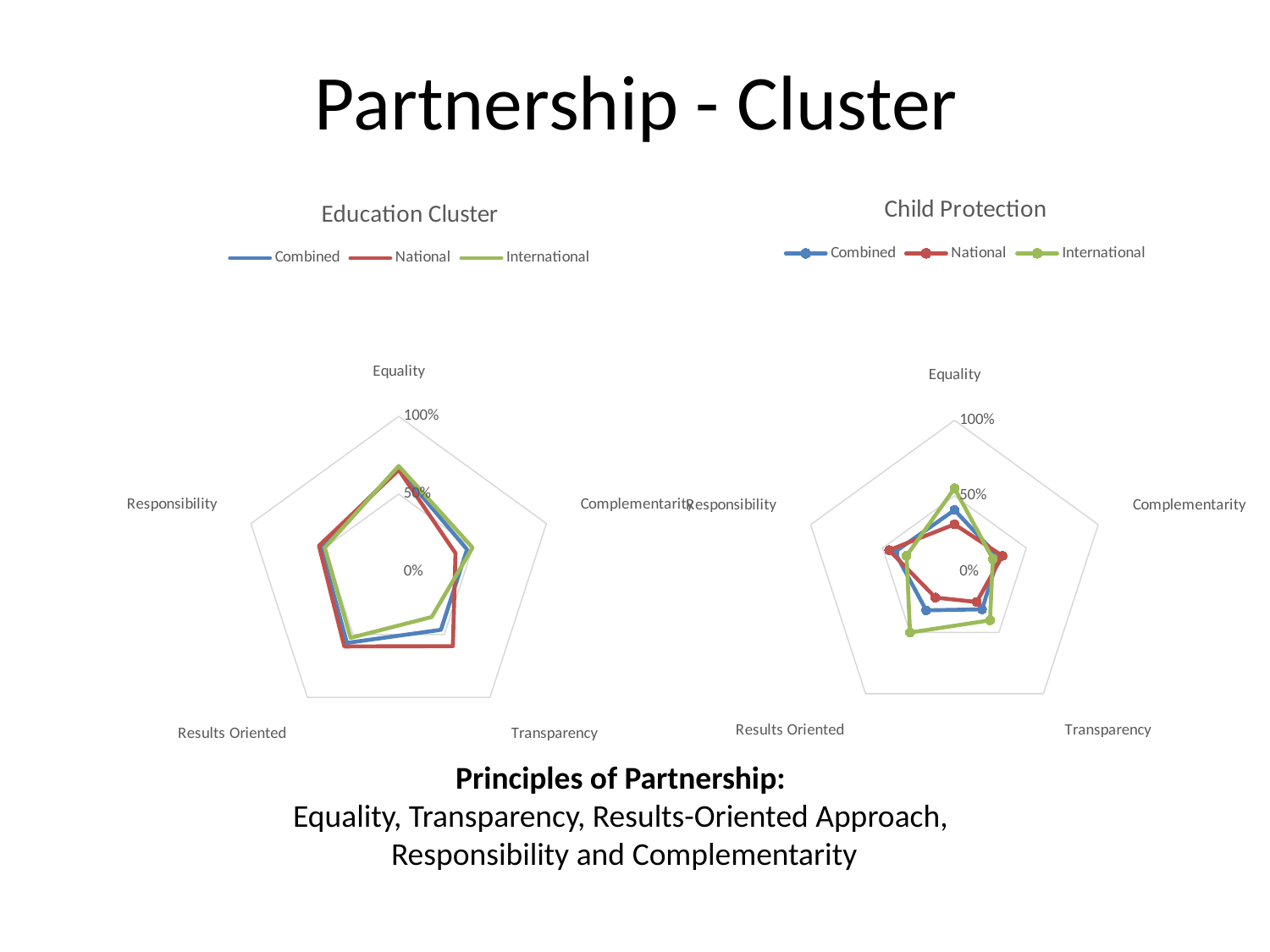
What are the series names in the legend of the Child Protection chart? Combined, National, International In the Education Cluster chart, is the International value for Equality greater or less than 50%? greater What is the title of the chart on the left of the slide? Education Cluster How many categories (axes) does the Child Protection chart have? 5 How many series does the legend of the Education Cluster chart list? 3 What kind of chart is the Education Cluster chart? Radar chart In the Education Cluster chart, is the National value for Equality greater or less than 50%? greater In the Child Protection chart, is the National value for Equality greater or less than 50%? less In the Child Protection chart, which series has the higher value for Equality, International or National? International In the Child Protection chart, which series has the higher value for Transparency, International or National? International